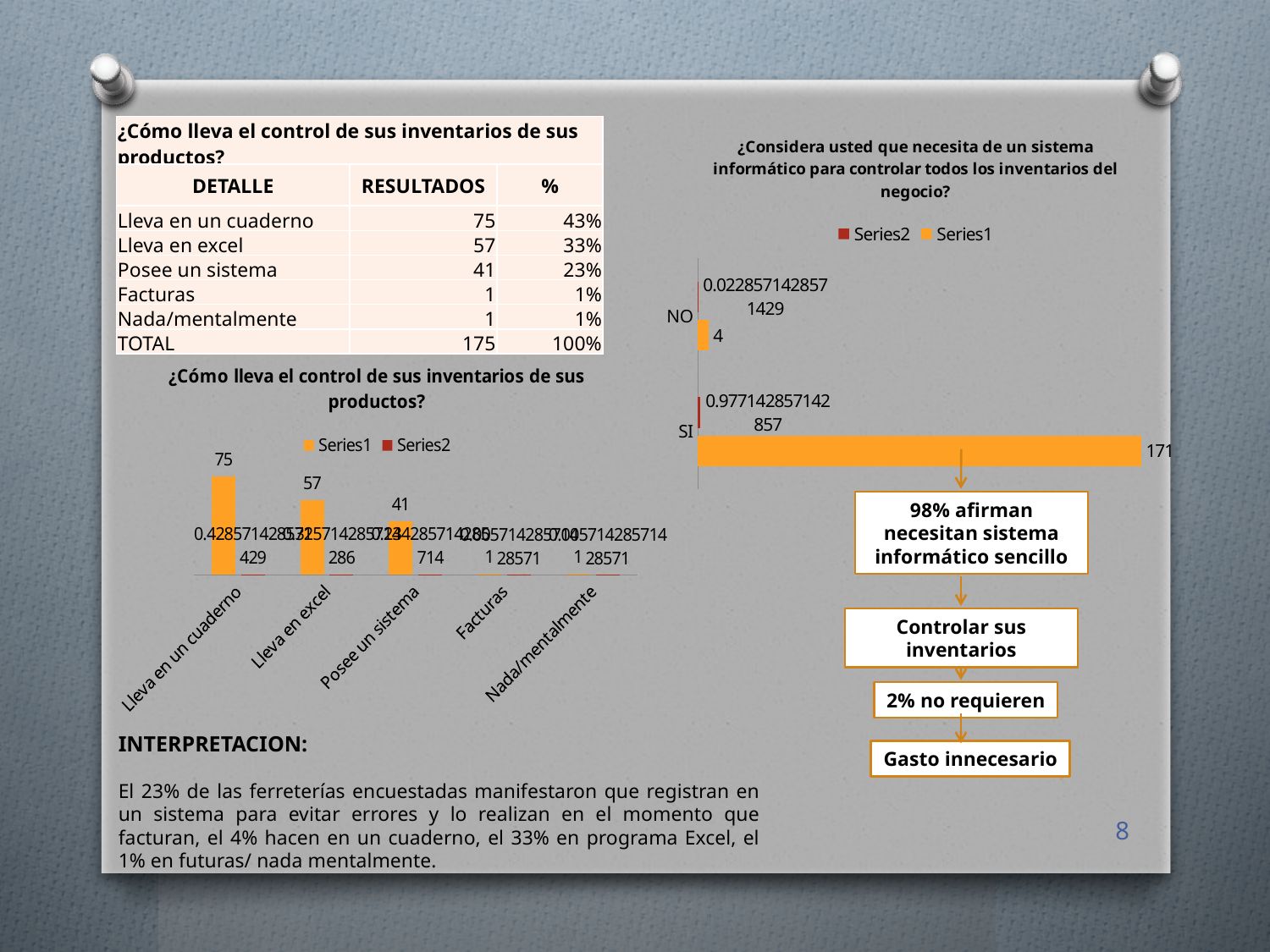
In the chart titled '¿Cómo lleva el control de sus inventarios de sus productos?', what is the Series1 value for 'Lleva en un cuaderno'? 75 In the chart titled '¿Cómo lleva el control de sus inventarios de sus productos?', which category has the highest Series1 value? Lleva en un cuaderno In the chart titled '¿Cómo lleva el control de sus inventarios de sus productos?', what is the difference between the Series1 values for 'Lleva en un cuaderno' and 'Lleva en excel'? 18 In the chart titled '¿Cómo lleva el control de sus inventarios de sus productos?', what is the Series1 value for 'Lleva en excel'? 57 In the chart on the right about needing a 'sistema informático', what is the Series1 value for 'NO'? 4 In the chart titled '¿Cómo lleva el control de sus inventarios de sus productos?', how many series does the legend list? 2 In the chart on the right about needing a 'sistema informático', what is the Series1 value for 'SI'? 171 In the chart on the right about needing a 'sistema informático', which category has the larger Series1 value, 'SI' or 'NO'? SI In the chart titled '¿Cómo lleva el control de sus inventarios de sus productos?', how many categories are shown on the x axis? 5 In the chart on the right about needing a 'sistema informático', what is the difference between the Series1 values for 'SI' and 'NO'? 167 What kind of chart is the one titled '¿Cómo lleva el control de sus inventarios de sus productos?'? Bar chart In the chart titled '¿Cómo lleva el control de sus inventarios de sus productos?', what is the Series1 value for 'Posee un sistema'? 41